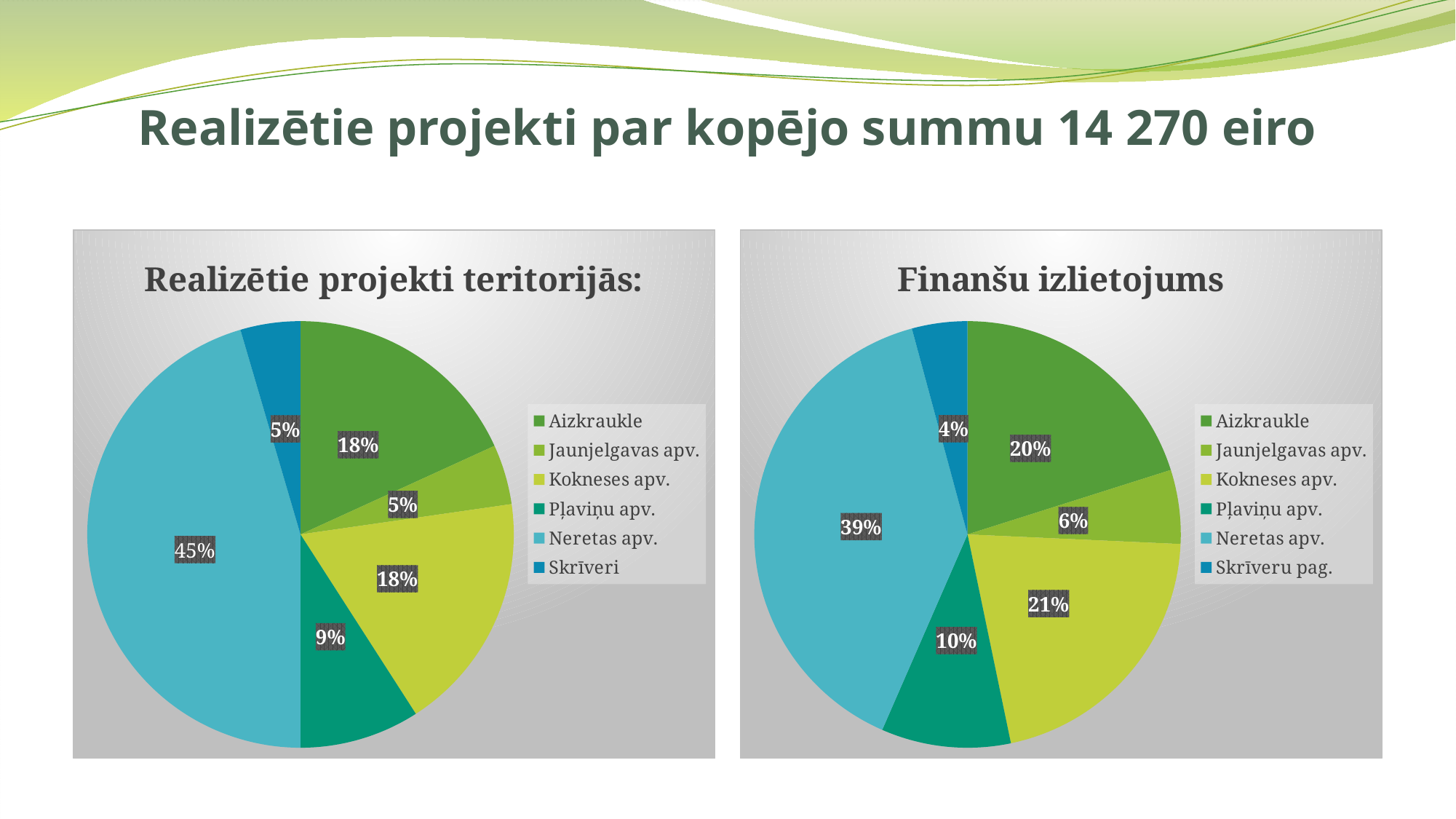
In the 'Finanšu izlietojums' chart, which category has the smallest share? Skrīveru pag. In the 'Finanšu izlietojums' chart, which category has the largest share? Neretas apv. What is the title of the chart on the right side of the slide? Finanšu izlietojums In the 'Realizētie projekti teritorijās:' chart, what is the value for Pļaviņu apv.? 9% In the 'Finanšu izlietojums' chart, what share does Kokneses apv. have? 21% In the 'Finanšu izlietojums' chart, what is the value for Skrīveru pag.? 4% In the 'Finanšu izlietojums' chart, what is the difference between the shares of Neretas apv. and Aizkraukle? 19% In the 'Realizētie projekti teritorijās:' chart, which category has the largest share? Neretas apv. In the 'Realizētie projekti teritorijās:' chart, what share does Neretas apv. have? 45% What type of chart is the 'Realizētie projekti teritorijās:' chart? Pie chart In the 'Realizētie projekti teritorijās:' chart, which is larger, the share of Kokneses apv. or Pļaviņu apv.? Kokneses apv. How many categories does the 'Finanšu izlietojums' chart show? 6